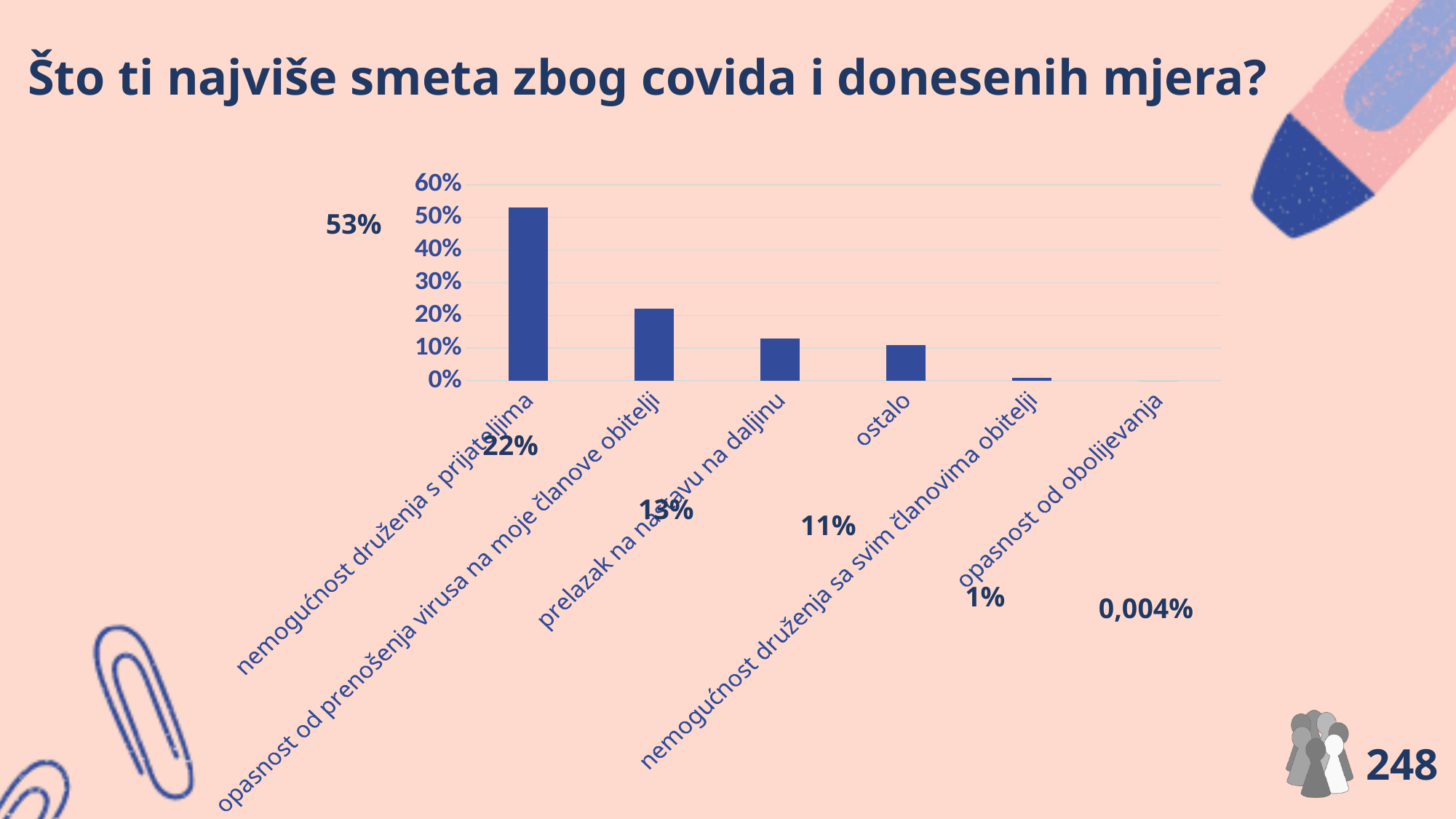
Is the value for "nemogućnost druženja s prijateljima" greater or less than 50%? greater What is the difference between the values for "nemogućnost druženja s prijateljima" and "opasnost od prenošenja virusa na moje članove obitelji"? 31% How many categories does the chart show? 6 What is the value for "nemogućnost druženja s prijateljima"? 53% Which category has the lowest value? opasnost od obolijevanja What is the value for "ostalo"? 11% What kind of chart is shown on the slide? bar chart Which category has the highest value? nemogućnost druženja s prijateljima What is the value for "opasnost od prenošenja virusa na moje članove obitelji"? 22% What is the title of the slide? Što ti najviše smeta zbog covida i donesenih mjera? What is the value for "opasnost od obolijevanja"? 0,004% Which is larger, the value for "prelazak na nastavu na daljinu" or the value for "ostalo"? prelazak na nastavu na daljinu